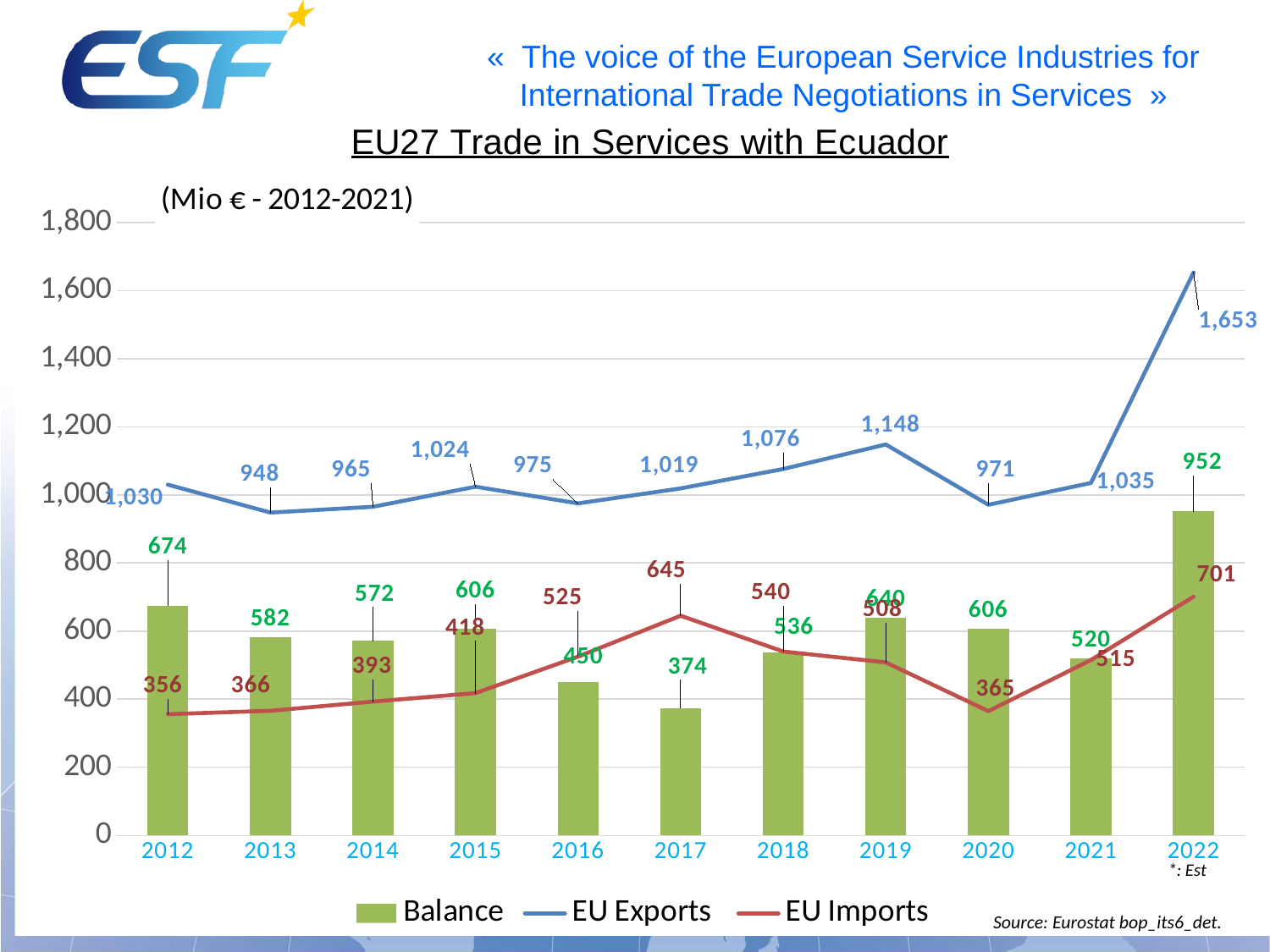
What is the value of EU Imports in 2012? 356 In which year is the Balance lowest? 2017 Which series is shown as green bars? Balance What is the Balance value for 2017? 374 Which is larger in 2016: the Balance or EU Imports? EU Imports In which year are EU Exports highest? 2022 What is the value of EU Exports in 2022? 1,653 How many series does the legend list? 3 How many years are shown on the x axis? 11 Is the value of EU Exports in 2019 greater or less than 1,000? greater What kind of chart is this? Combined bar and line chart What is the difference between EU Exports and EU Imports in 2020? 606